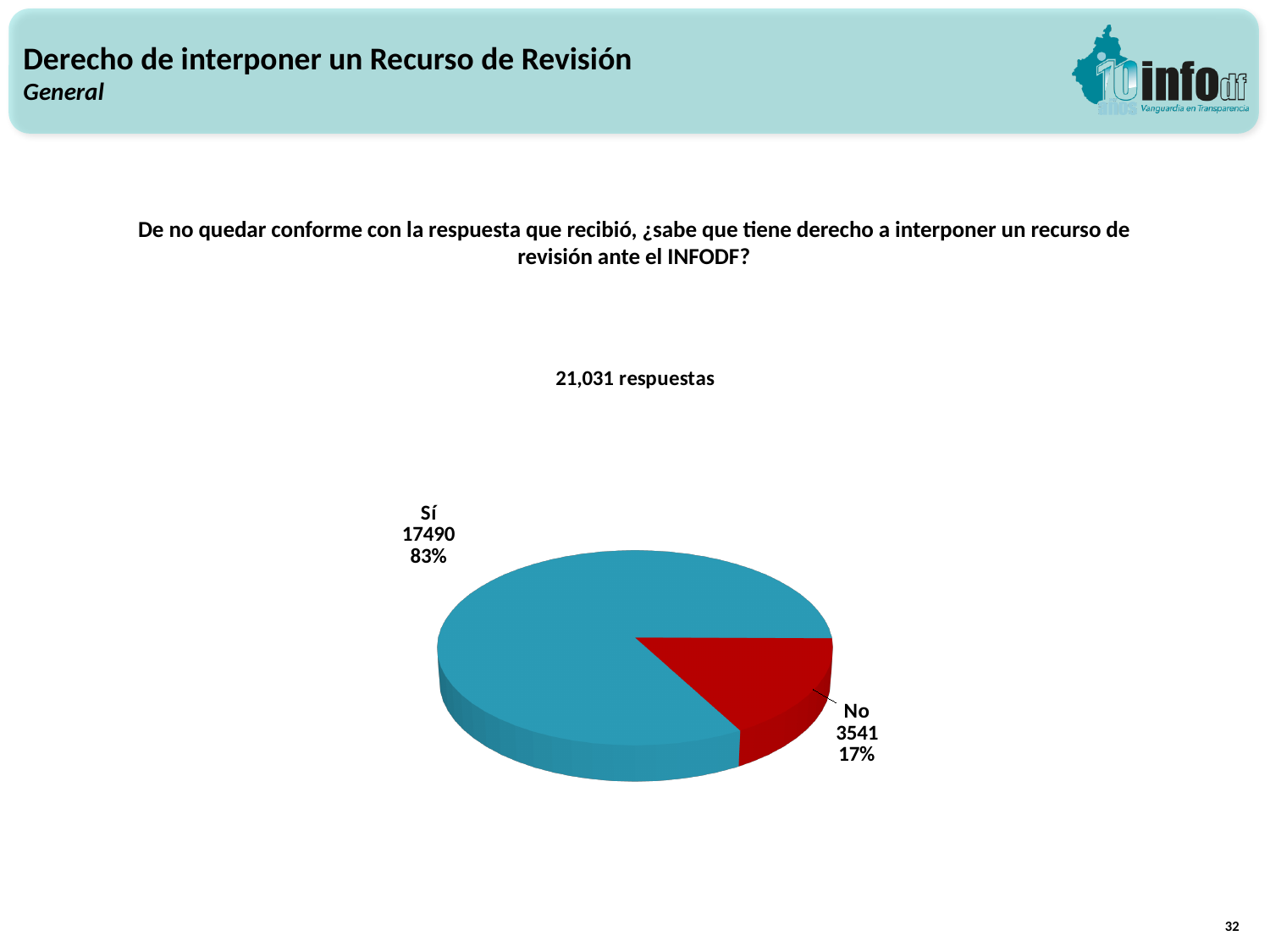
How many respondents answered "Sí"? 17490 What colour is the "No" slice of the pie? red How many slices does the pie chart have? 2 Which is larger, the number of "Sí" responses or the number of "No" responses? Sí Which answer has the smallest slice of the pie? No Which answer has the largest slice of the pie? Sí How many respondents answered "No"? 3541 What percentage of responses were "No"? 17% What kind of chart is shown on the slide? pie chart What is the total number of responses shown above the chart? 21,031 respuestas What percentage of responses were "Sí"? 83% What is the difference between the number of "Sí" and "No" responses? 13949